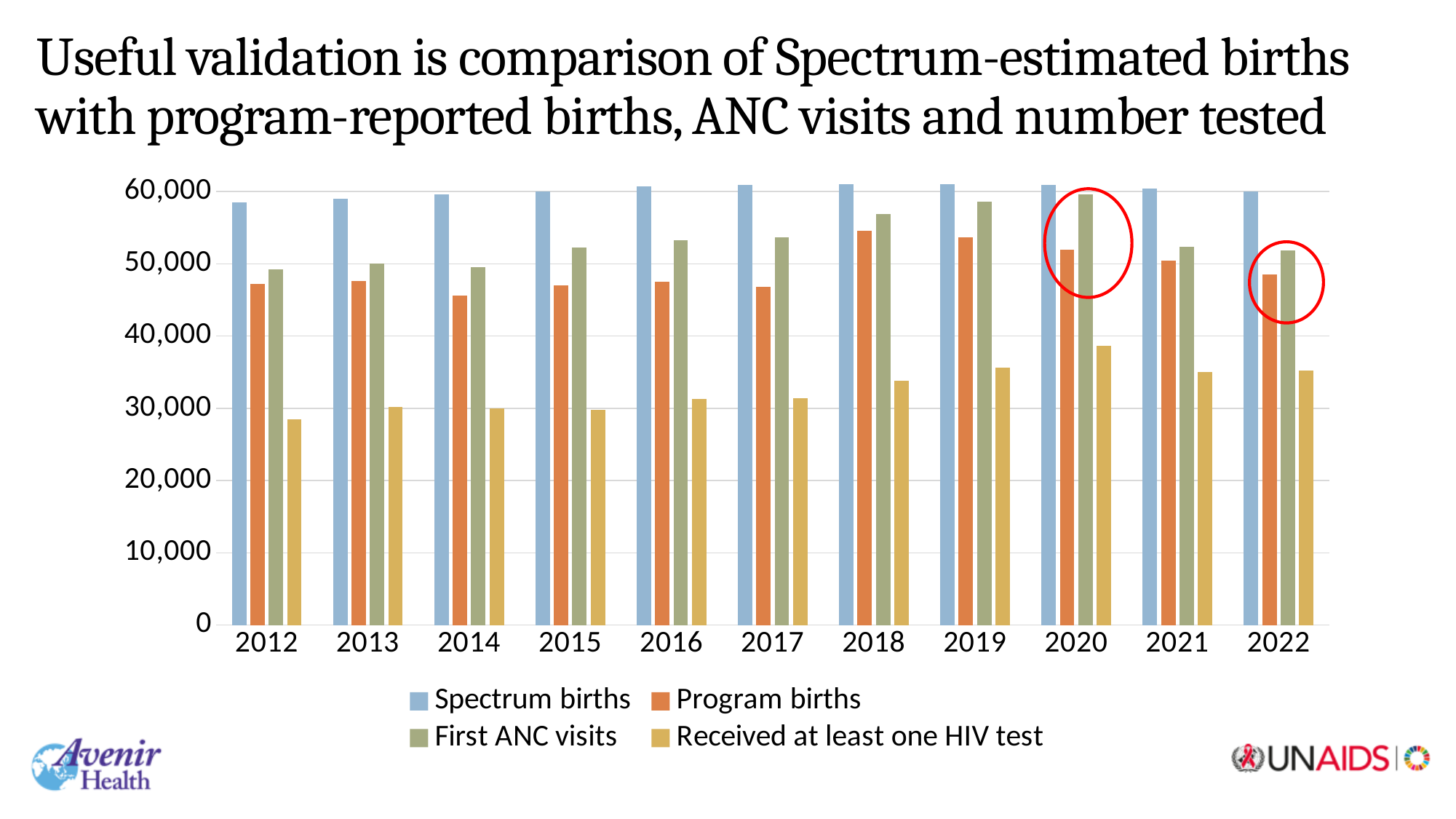
What kind of chart is shown on the slide? Bar chart In 2018, which is larger: Program births or First ANC visits? First ANC visits Is the value for First ANC visits in 2020 greater or less than 50,000? greater Which years have bars circled in red? 2020 and 2022 Is the value for Received at least one HIV test in 2012 greater or less than 30,000? less Is the value for Spectrum births in 2012 greater or less than 60,000? less How many years are shown on the x axis? 11 Which series has the lowest value in every year? Received at least one HIV test How many series does the legend list? 4 Which series has the highest value in every year? Spectrum births Which is larger: Received at least one HIV test in 2020 or in 2012? 2020